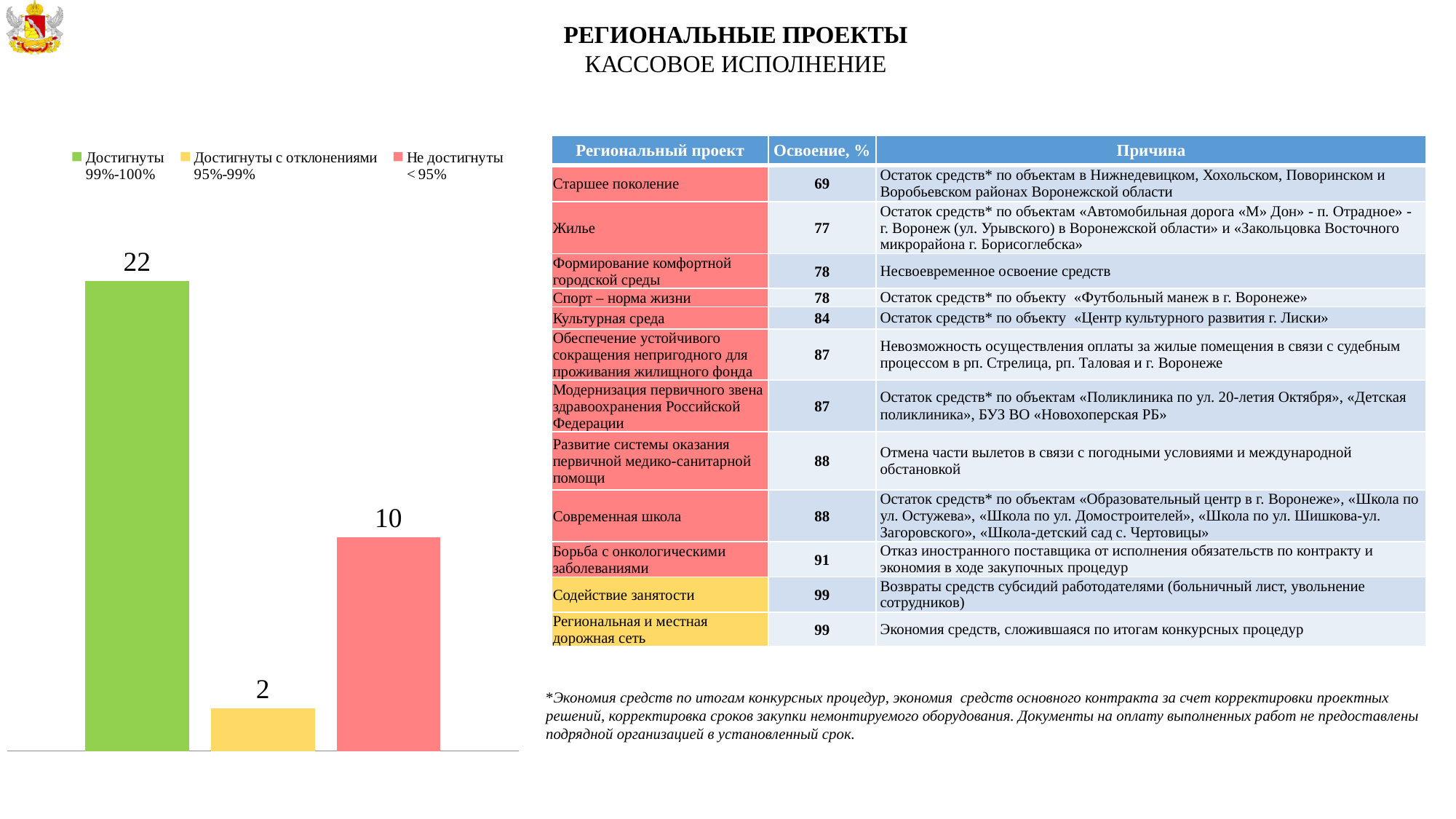
What type of chart is shown on the left of the slide? Bar chart What is the value of the bar for «Не достигнуты < 95%»? 10 How many entries does the chart legend list? 3 What is the value of the bar for «Достигнуты 99%-100%»? 22 What colour is the bar for «Не достигнуты < 95%»? Red Which category has the lowest bar in the chart? Достигнуты с отклонениями 95%-99% How many bars are plotted in the chart? 3 Which is larger: the bar for «Не достигнуты < 95%» or the bar for «Достигнуты с отклонениями 95%-99%»? Не достигнуты < 95% What is the difference between the «Достигнуты 99%-100%» bar and the «Не достигнуты < 95%» bar? 12 What is the difference between the «Не достигнуты < 95%» bar and the «Достигнуты с отклонениями 95%-99%» bar? 8 What is the value of the bar for «Достигнуты с отклонениями 95%-99%»? 2 Which category has the highest bar in the chart? Достигнуты 99%-100%